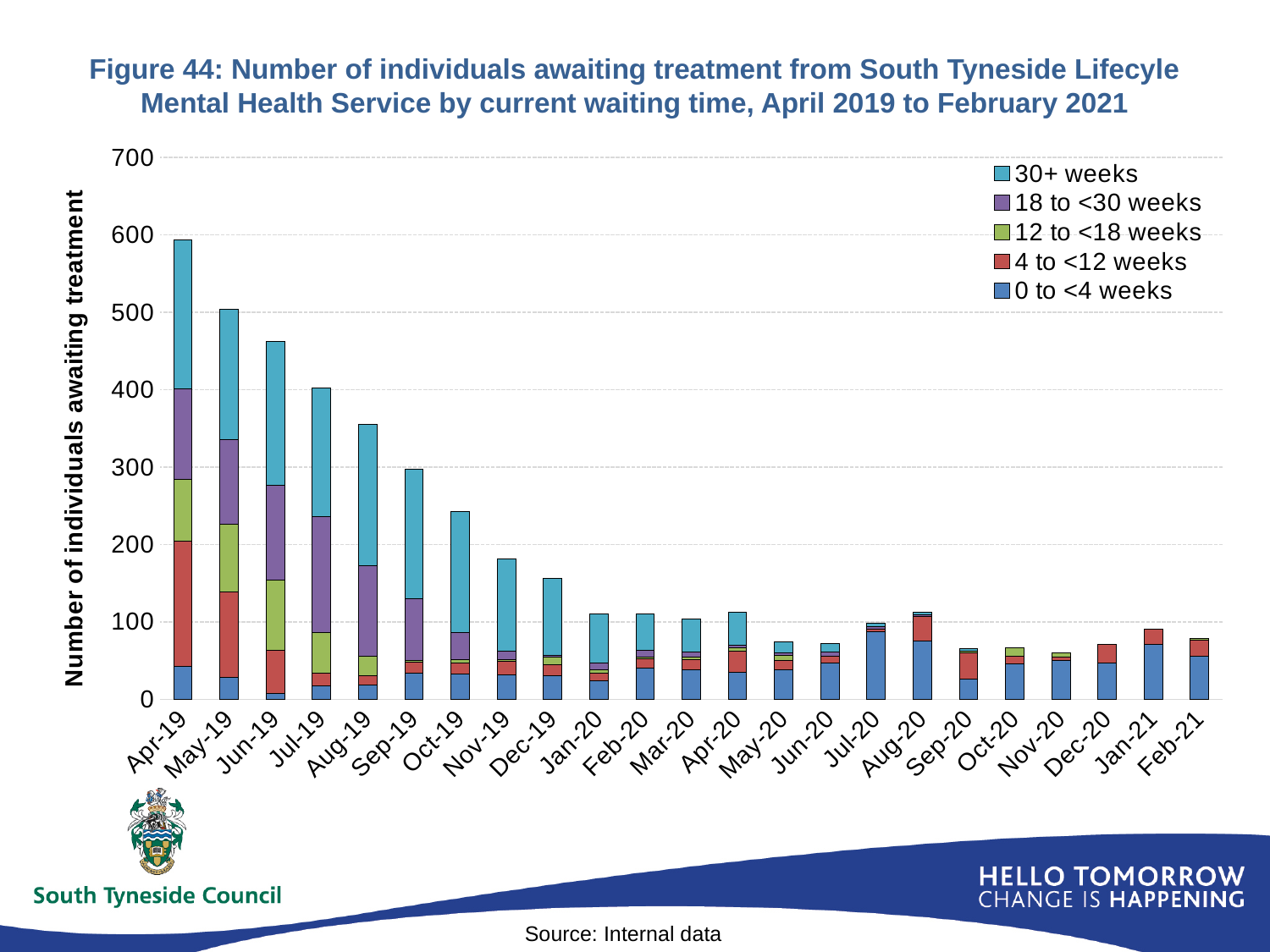
Which has the larger total number awaiting treatment, Jun-19 or Jul-19? Jun-19 Which waiting-time band is listed first (at the top) in the legend? 30+ weeks How many months (bars) are shown along the x axis? 23 Is the total number awaiting treatment in Jun-19 greater or less than 400? greater How many series does the legend list? 5 Which month has the highest total number of individuals awaiting treatment? Apr-19 What is the label on the y axis? Number of individuals awaiting treatment Is the total number awaiting treatment in Apr-19 greater or less than 500? greater What kind of chart is shown on the slide? Stacked bar chart Is the total number awaiting treatment in Nov-19 greater or less than 200? less Overall, does the total number of individuals awaiting treatment rise or fall from Apr-19 to Feb-21? Fall